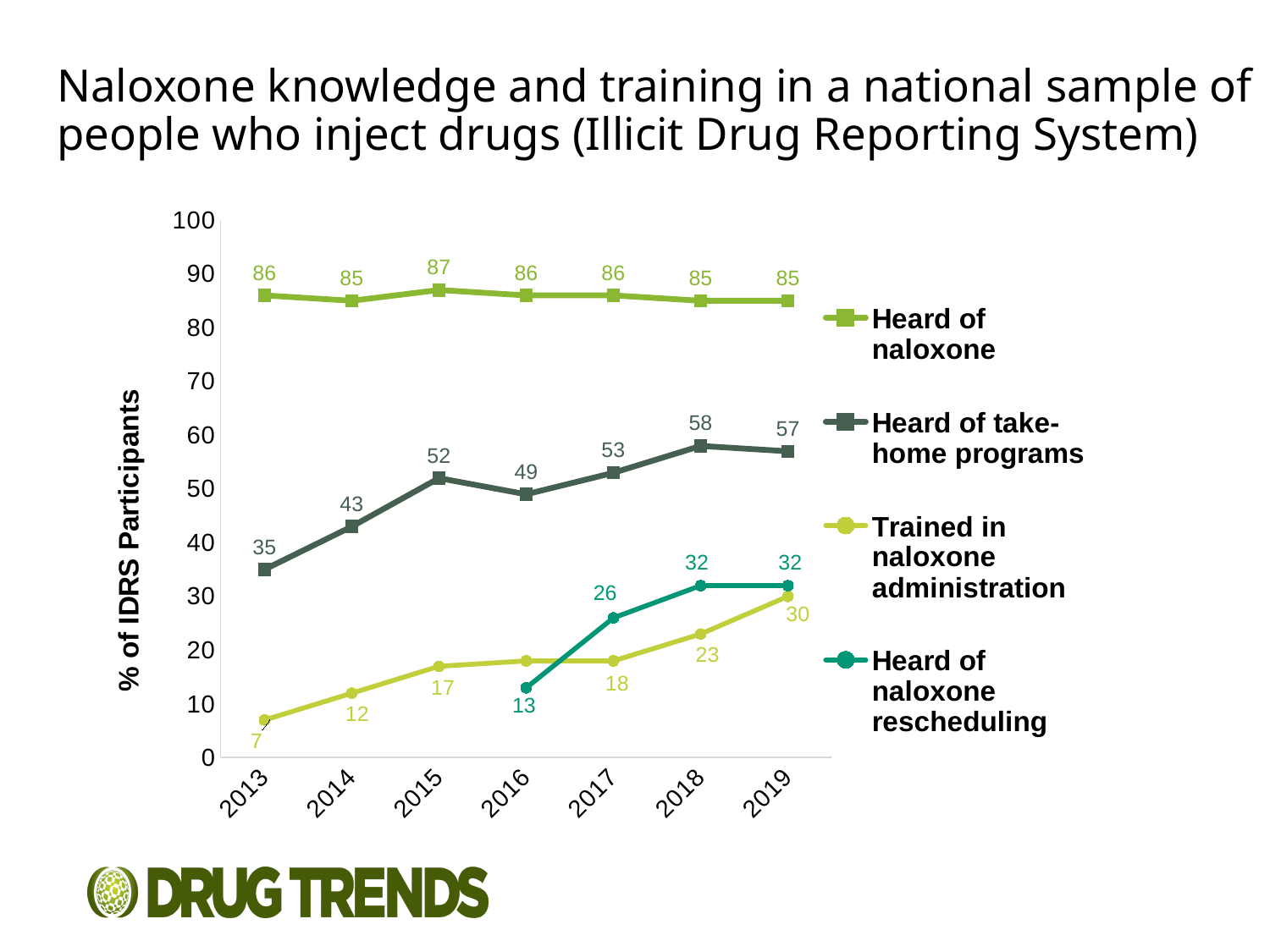
Which was higher in 2019: 'Trained in naloxone administration' or 'Heard of naloxone rescheduling'? Heard of naloxone rescheduling Does the 'Heard of take-home programs' series generally rise or fall from 2013 to 2019? Rise What was the value for 'Heard of naloxone rescheduling' in 2017? 26 How many years are shown on the x axis? 7 How many series does the legend list? 4 In which year was the 'Heard of naloxone' series at its highest? 2015 What was the value for 'Trained in naloxone administration' in 2019? 30 In which year was the 'Trained in naloxone administration' series at its lowest? 2013 What is the label on the y axis? % of IDRS Participants What percentage of IDRS participants had heard of take-home programs in 2016? 49 By how many percentage points did 'Heard of take-home programs' increase from 2013 to 2019? 22 What kind of chart is shown on the slide? Line chart